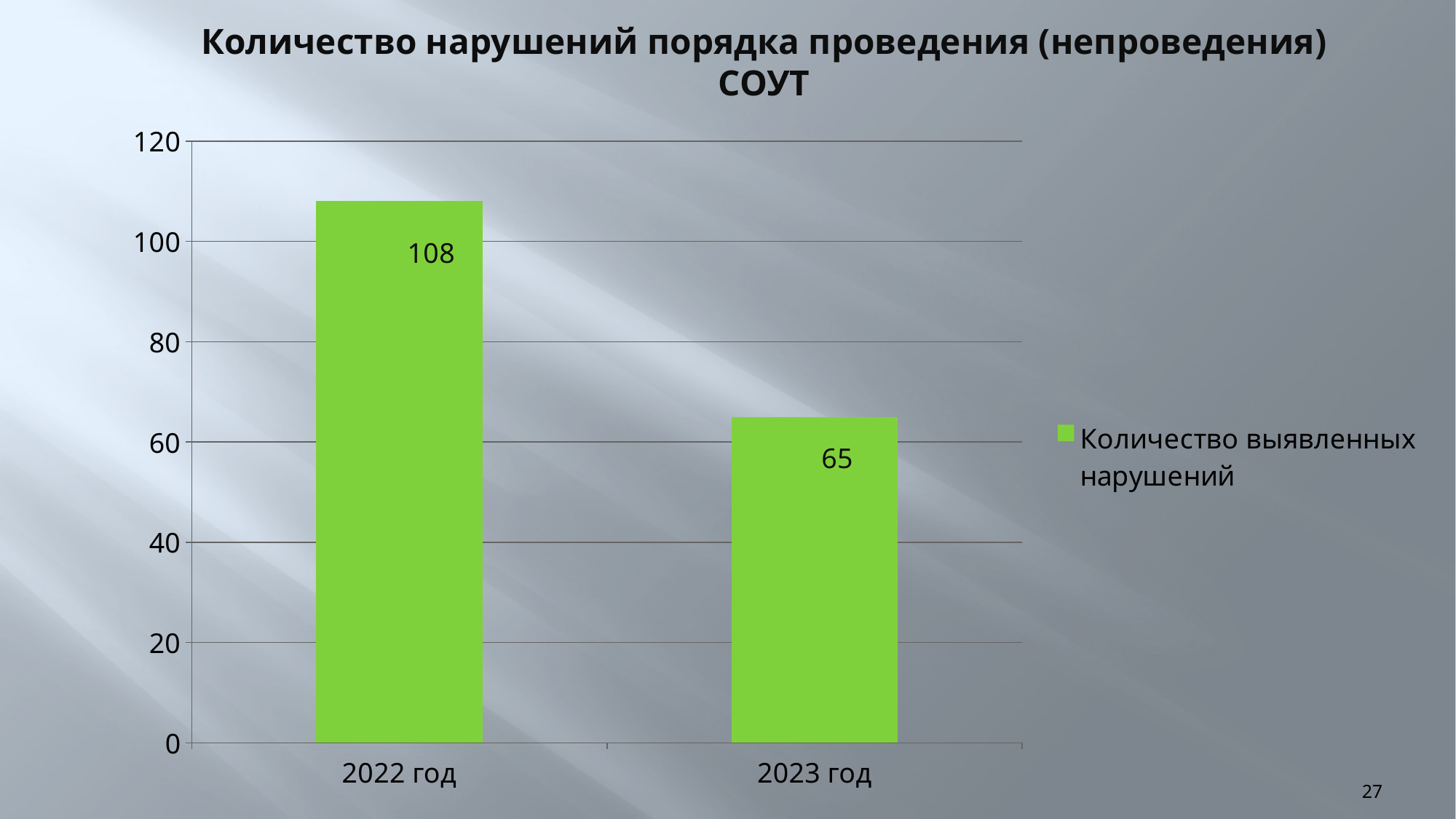
What is the value for 2022 год? 108 What is the value for 2023 год? 65 Is the value for 2023 год greater or less than 80? less How many categories are shown on the x axis? 2 Is the value for 2022 год greater or less than 100? greater What kind of chart is shown on the slide? bar chart Do the values rise or fall from 2022 год to 2023 год? fall What is the difference between the values for 2022 год and 2023 год? 43 How many series does the legend list? 1 Which year has the lowest number of identified violations? 2023 год Which year has the highest number of identified violations? 2022 год Which is larger, the value for 2022 год or the value for 2023 год? 2022 год